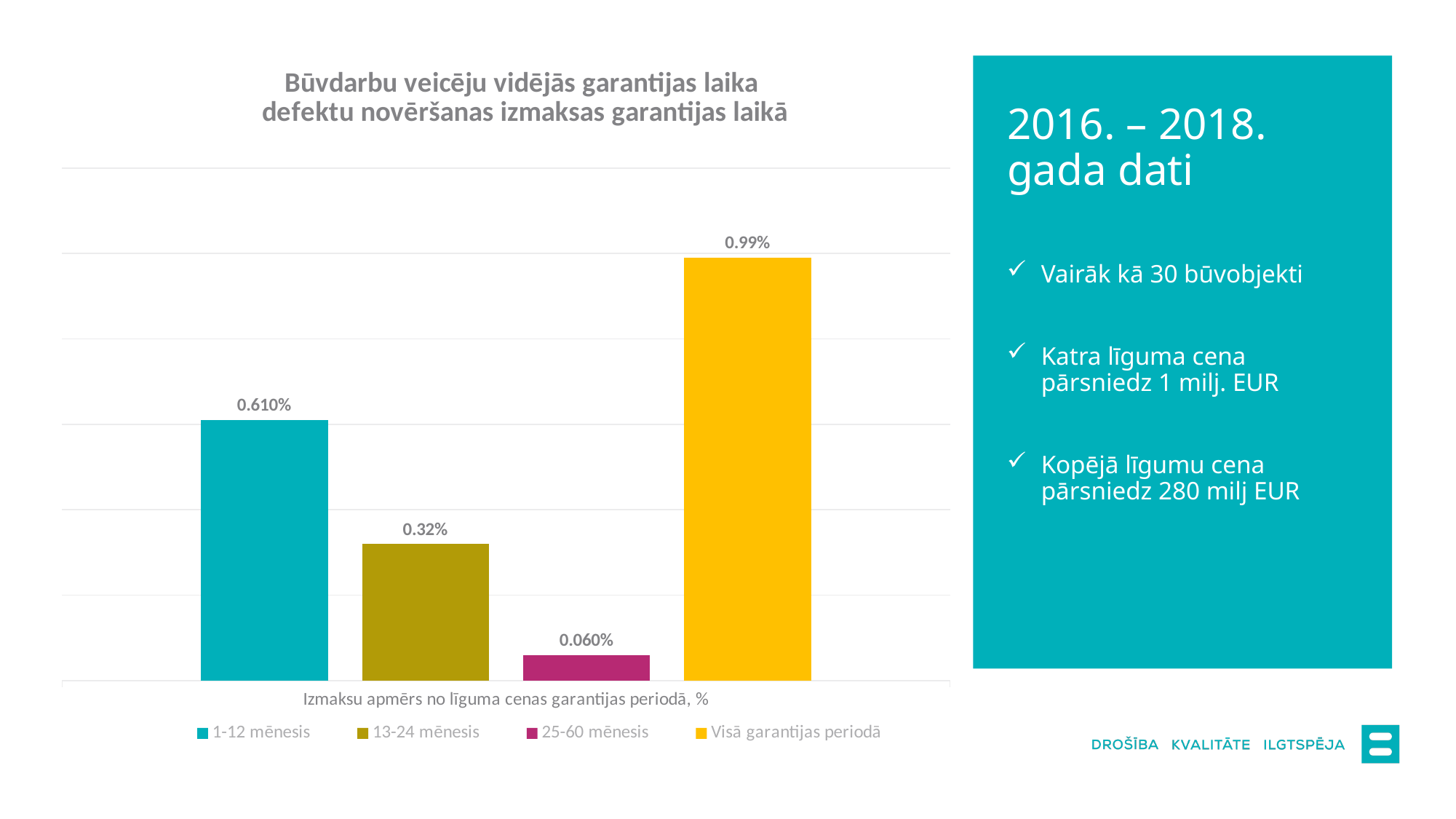
Which series has the lowest value? 25-60 mēnesis What is the value for Visā garantijas periodā? 0.99% What is the difference between the values for 1-12 mēnesis and 13-24 mēnesis? 0.29% How many series does the legend list? 4 What is the value for 25-60 mēnesis? 0.060% What is the value for 1-12 mēnesis? 0.610% What kind of chart is shown on the slide? Bar chart Which series has the highest value? Visā garantijas periodā What is the difference between the values for Visā garantijas periodā and 1-12 mēnesis? 0.38% Which is larger, the value for 13-24 mēnesis or the value for 25-60 mēnesis? 13-24 mēnesis What is the value for 13-24 mēnesis? 0.32% What is the x-axis label of the chart? Izmaksu apmērs no līguma cenas garantijas periodā, %